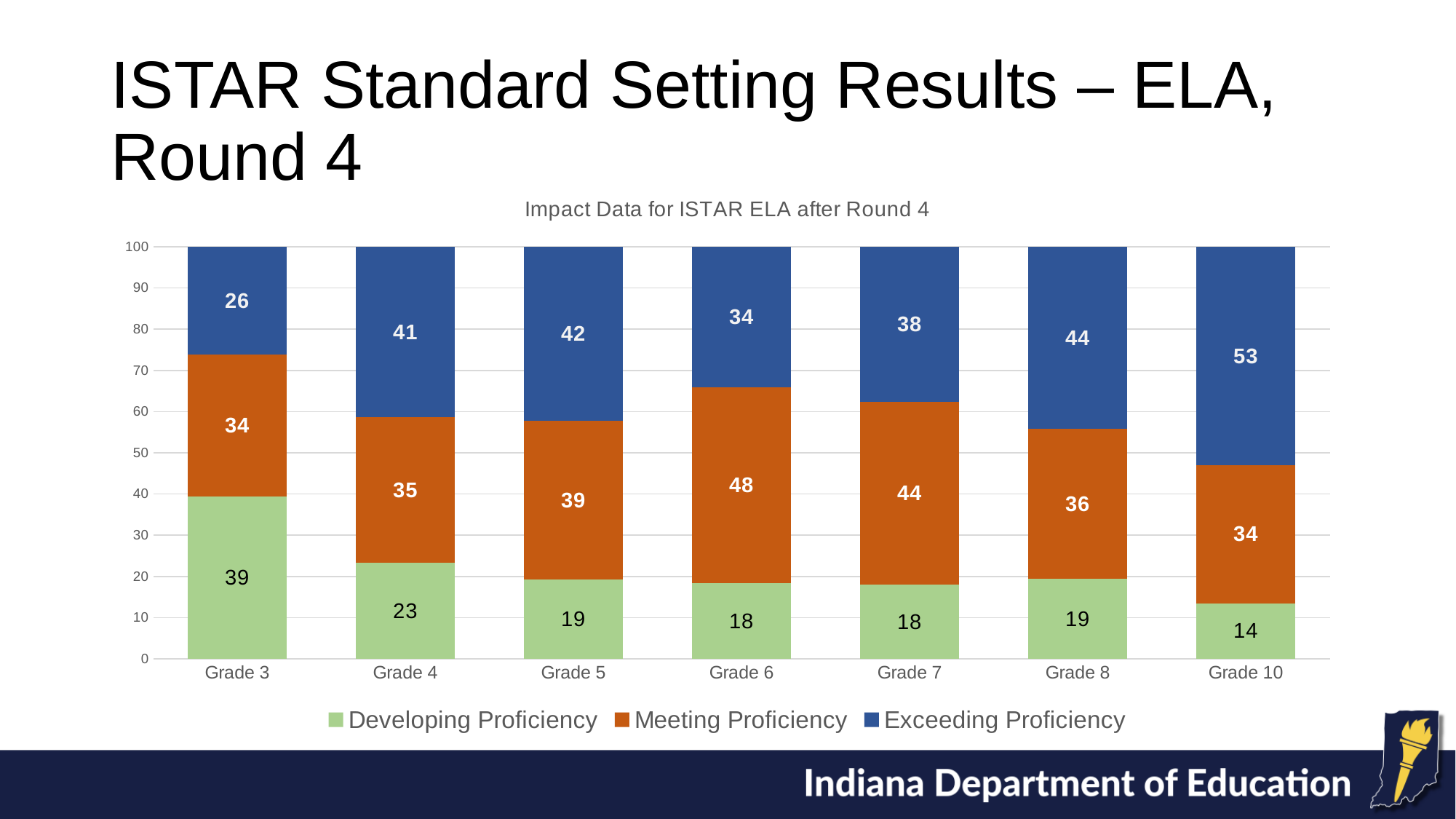
Which grade has the highest Exceeding Proficiency value? Grade 10 What is the Developing Proficiency value for Grade 3? 39 What is the title of the chart? Impact Data for ISTAR ELA after Round 4 What is the difference between the Exceeding Proficiency values for Grade 10 and Grade 3? 27 How many series does the legend list? 3 What kind of chart is shown? Stacked bar chart Which grade has the highest Meeting Proficiency value? Grade 6 What is the Meeting Proficiency value for Grade 6? 48 Which is larger, the Meeting Proficiency value for Grade 7 or for Grade 8? Grade 7 What is the Exceeding Proficiency value for Grade 10? 53 Which grade has the lowest Developing Proficiency value? Grade 10 How many grades are shown on the x axis? 7